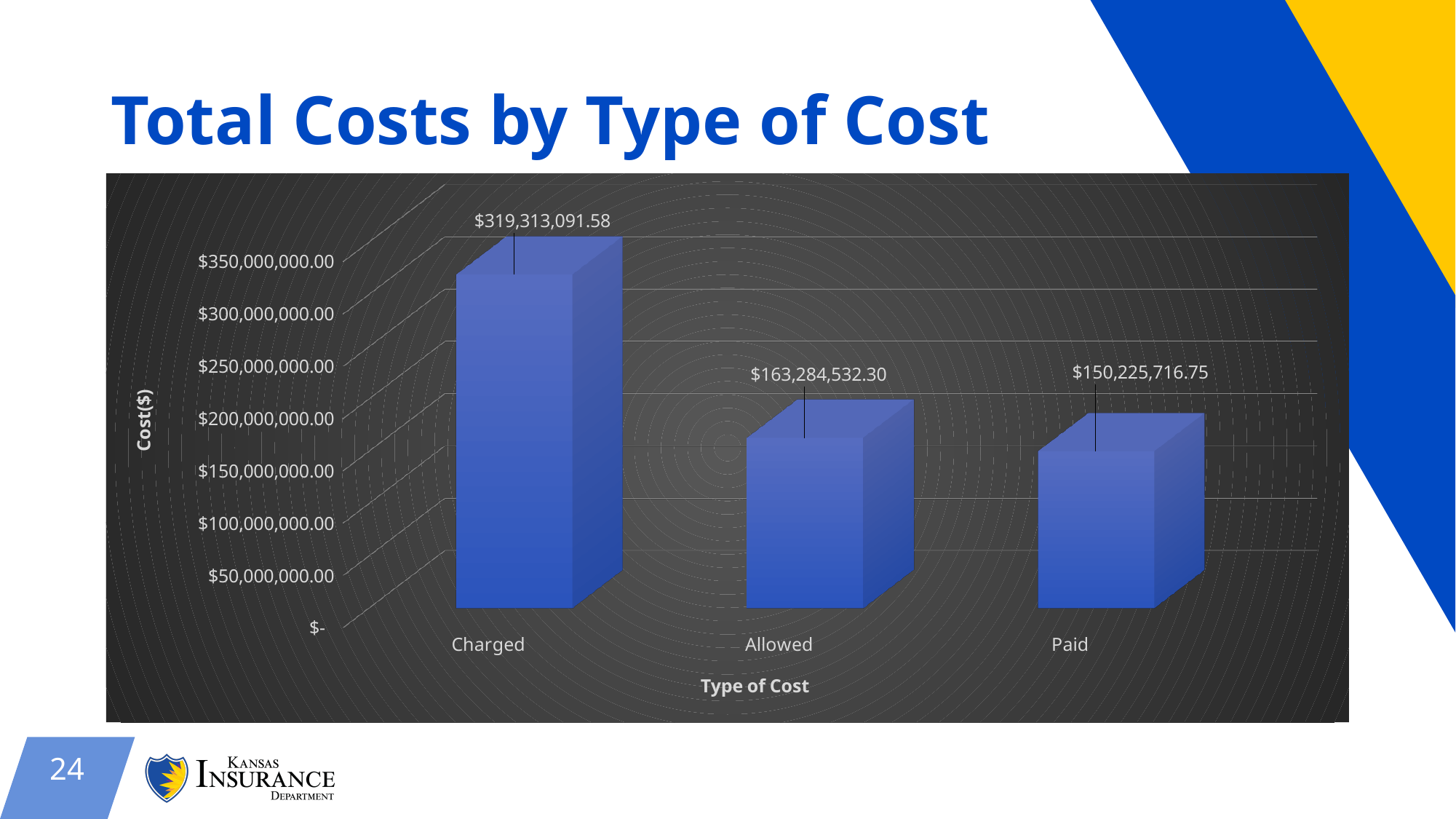
How many types of cost are shown on the chart? 3 Is the value for Charged greater or less than $300,000,000.00? greater What is the value for Allowed? $163,284,532.30 What is the value for Paid? $150,225,716.75 What is the difference between the Allowed and Paid values? $13,058,815.55 What kind of chart is shown on the slide? bar chart Which type of cost has the lowest total? Paid Which type of cost has the highest total? Charged What is the label of the vertical axis? Cost($) What is the value for Charged? $319,313,091.58 What is the difference between the Charged and Allowed values? $156,028,559.28 Which is larger, the value for Charged or the value for Paid? Charged